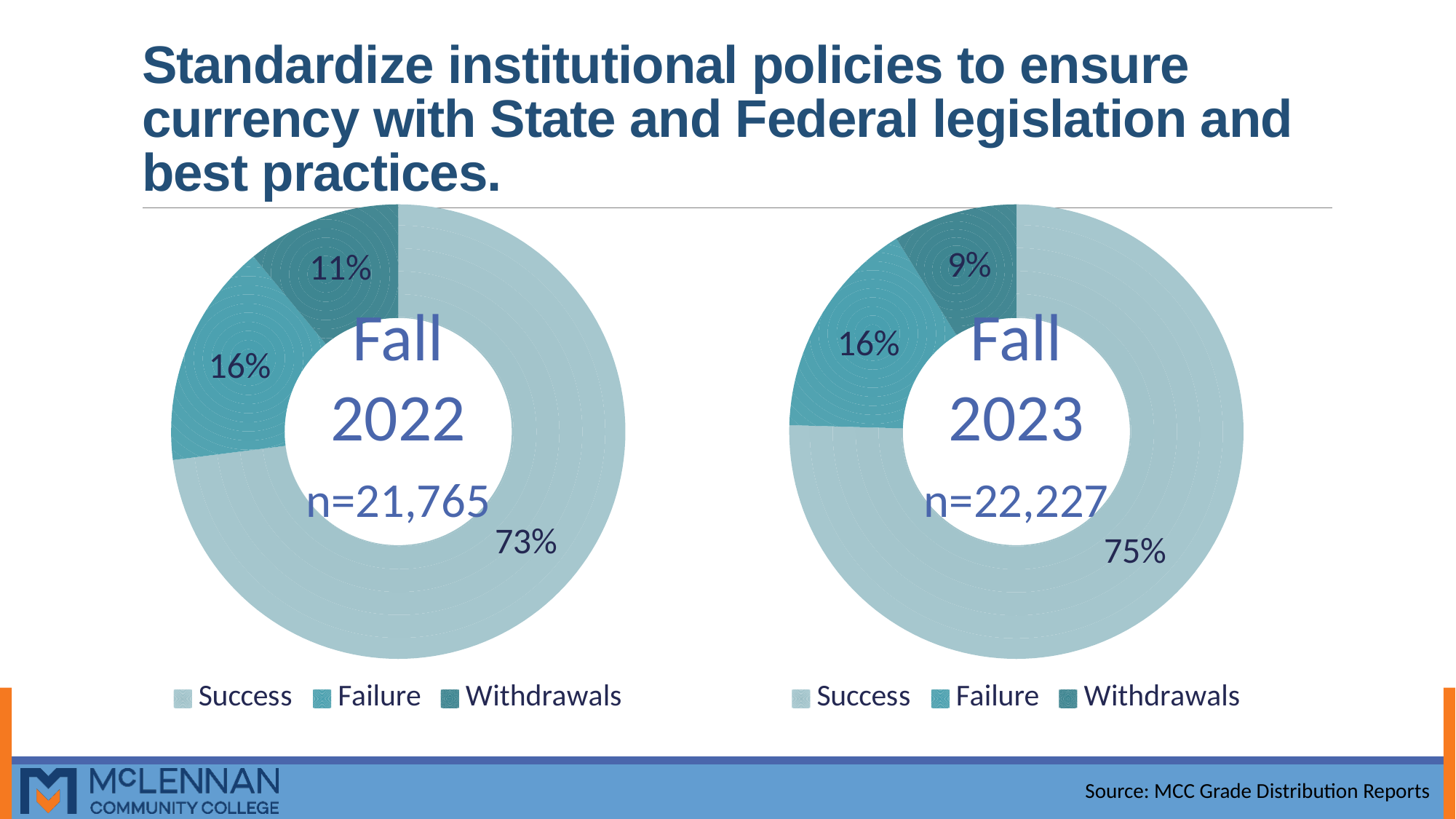
In the Fall 2022 chart, what percentage is labelled for Success? 73% In the Fall 2022 chart, which category has the largest share? Success In the Fall 2022 chart, what share of the pie is Withdrawals? 11% In the Fall 2023 chart, what percentage is labelled for Failure? 16% What kind of chart is the Fall 2023 chart? Doughnut (pie) chart What is the n value shown in the centre of the Fall 2023 chart? n=22,227 Which is larger: the Success share in the Fall 2022 chart or the Success share in the Fall 2023 chart? Fall 2023 How many categories does the Fall 2022 chart show? 3 In the Fall 2022 chart, what is the difference in percentage points between Failure and Withdrawals? 5 In the Fall 2023 chart, which category has the smallest share? Withdrawals What is the n value shown in the centre of the Fall 2022 chart? n=21,765 In the Fall 2023 chart, what percentage is labelled for Withdrawals? 9%